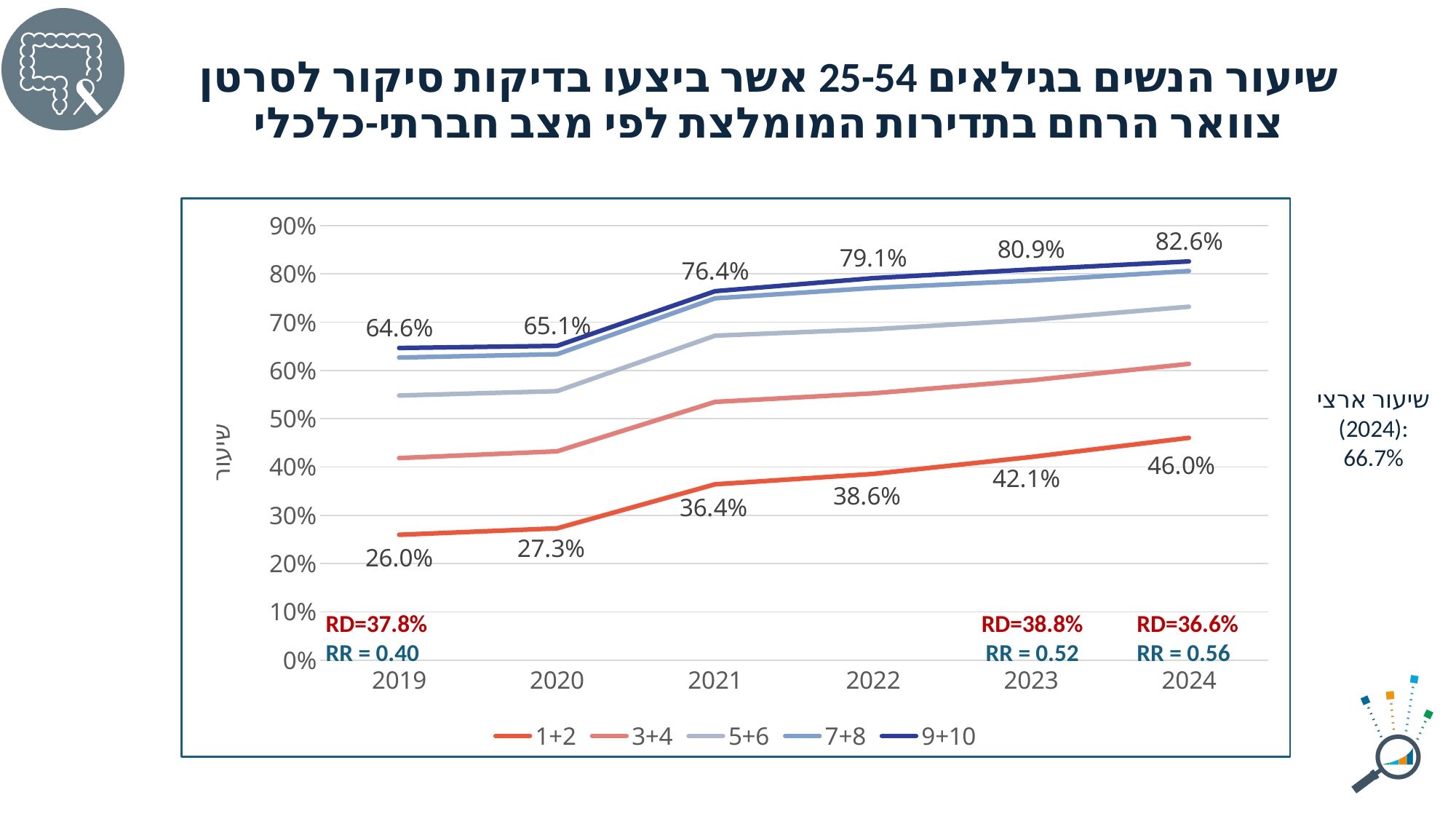
Which series has the larger value in 2020, 9+10 or 1+2? 9+10 In which year is the 9+10 series at its highest? 2024 What is the value for the 1+2 series in 2022? 38.6% What is the value for the 1+2 series in 2019? 26.0% What is the value for the 9+10 series in 2024? 82.6% How many series does the legend list? 5 Does the 1+2 series rise or fall from 2019 to 2024? rise What is the difference between the 9+10 and 1+2 series in 2021? 40.0% In which year is the 1+2 series at its lowest? 2019 How many years are shown on the x axis? 6 What kind of chart is shown on the slide? line chart Is the value for the 5+6 series in 2024 greater or less than 70%? greater